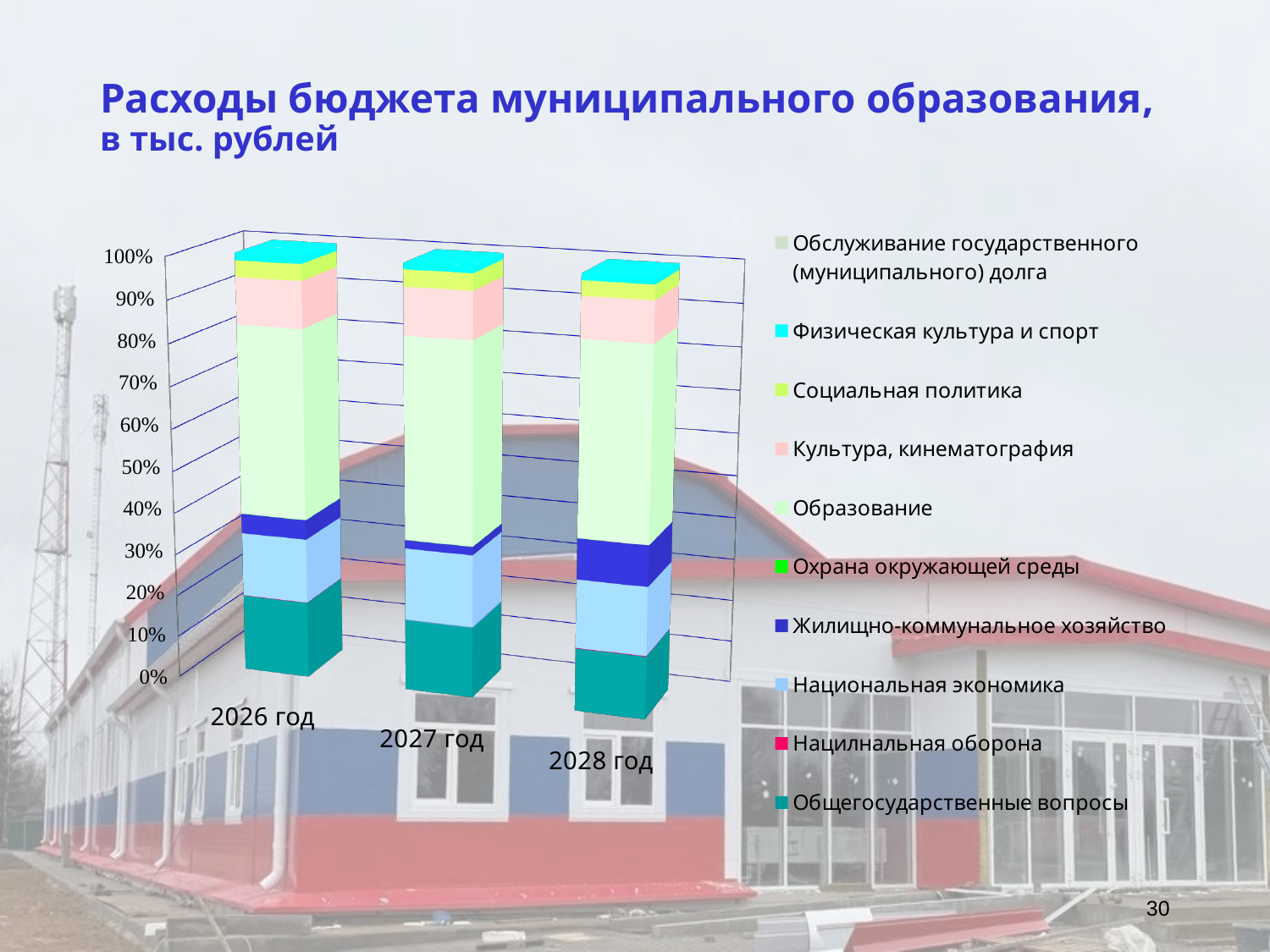
Which series takes up the largest share of the 2026 год bar? Образование In 2027 год, which is larger: the share for Национальная экономика or the share for Культура, кинематография? Национальная экономика In 2028 год, is the share for Социальная политика greater or less than 10%? less Which series takes up the largest share of the 2028 год bar? Образование What kind of chart is shown on the slide? stacked bar chart How many series does the chart legend list? 10 In 2027 год, is the share for Физическая культура и спорт greater or less than 10%? less How many years (categories) are shown on the x axis of the chart? 3 In 2026 год, is the share for Образование greater or less than 30%? greater In 2026 год, which is larger: the share for Образование or the share for Общегосударственные вопросы? Образование What is the title of the chart on the slide? Расходы бюджета муниципального образования, в тыс. рублей Which years are shown as categories along the x axis? 2026 год, 2027 год, 2028 год